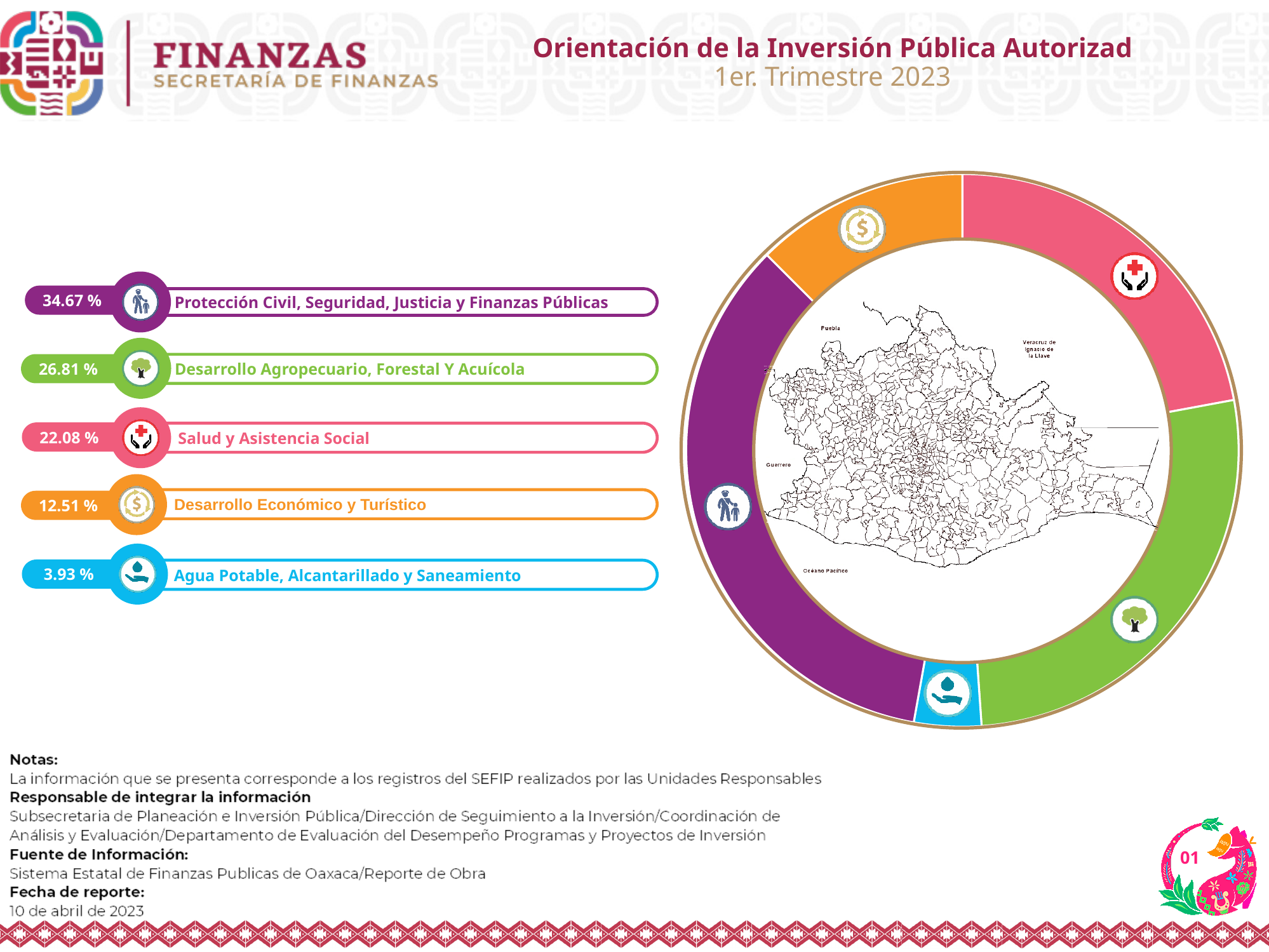
What is the difference in percentage points between Protección Civil, Seguridad, Justicia y Finanzas Públicas and Desarrollo Agropecuario, Forestal Y Acuícola? 7.86 What percentage is shown for Desarrollo Agropecuario, Forestal Y Acuícola? 26.81 % Which category has the largest share of the authorized public investment? Protección Civil, Seguridad, Justicia y Finanzas Públicas Which category has the smallest share of the authorized public investment? Agua Potable, Alcantarillado y Saneamiento Which has a larger share: Desarrollo Económico y Turístico or Salud y Asistencia Social? Salud y Asistencia Social How many categories are shown in the chart? 5 What kind of chart is used to show the distribution of the authorized public investment? Donut (pie) chart What percentage is shown for Salud y Asistencia Social? 22.08 % What share of the authorized public investment goes to Protección Civil, Seguridad, Justicia y Finanzas Públicas? 34.67 % What percentage is shown for Agua Potable, Alcantarillado y Saneamiento? 3.93 % What colour represents Desarrollo Económico y Turístico in the chart? Orange What is the difference in percentage points between Salud y Asistencia Social and Desarrollo Económico y Turístico? 9.57